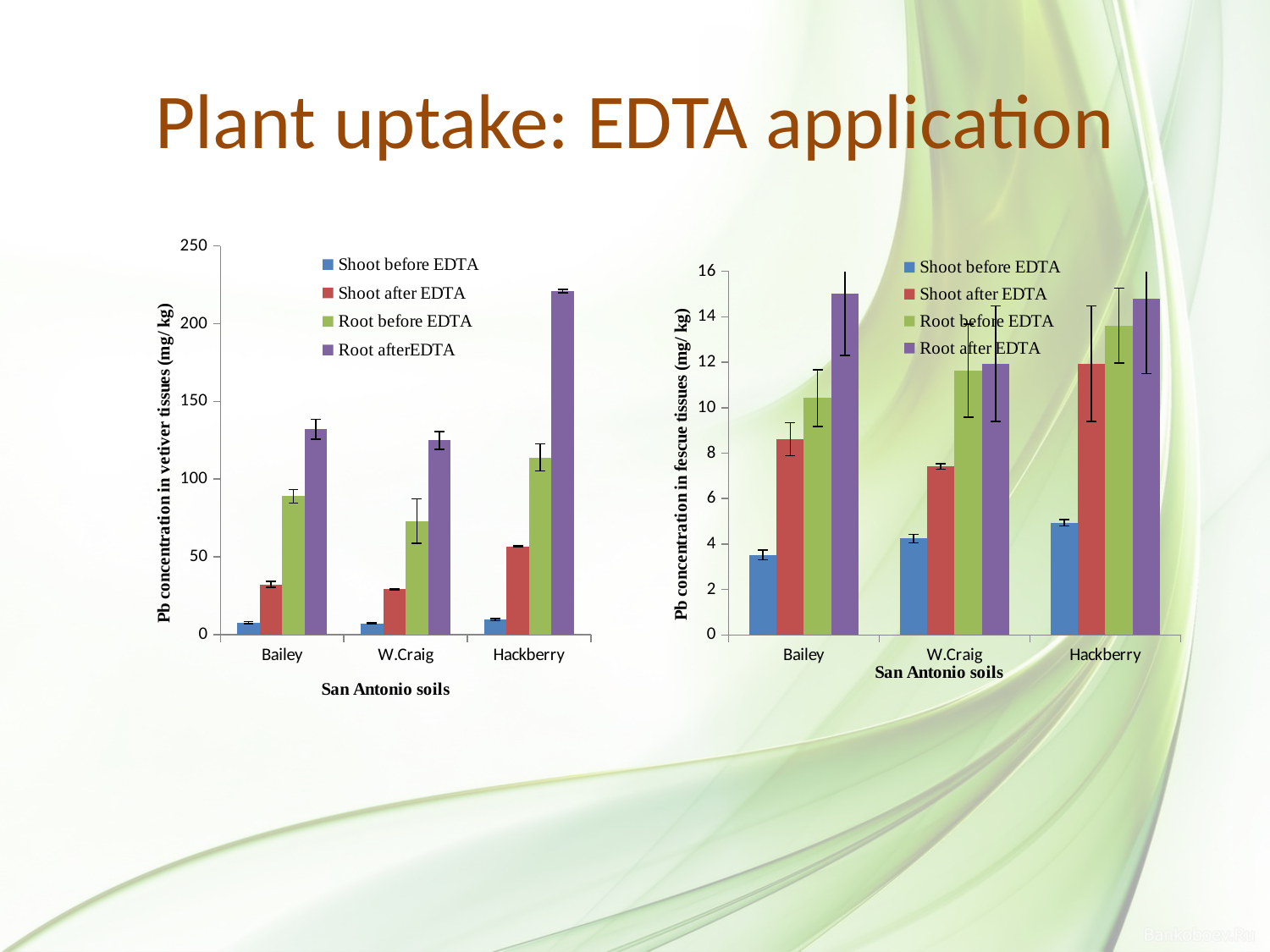
In the left chart (vetiver tissues), how many series does the legend list? 4 What is the y-axis label of the right chart? Pb concentration in fescue tissues (mg/ kg) In the left chart (vetiver tissues), which soil has the highest Root after EDTA value? Hackberry In the right chart (fescue tissues), is the Root after EDTA value for Bailey greater or less than 14? greater In the left chart (vetiver tissues), which is larger: the Shoot after EDTA value for Hackberry or for Bailey? Hackberry In the right chart (fescue tissues), is the Shoot after EDTA value for W.Craig greater or less than 8? less In the left chart (vetiver tissues), how many soil categories are shown on the x axis? 3 In the left chart (vetiver tissues), is the Root before EDTA value for Bailey greater or less than 100? less In the right chart (fescue tissues), which soil has the lowest Shoot before EDTA value? Bailey What kind of chart is the left chart (Pb concentration in vetiver tissues)? bar chart In the right chart (fescue tissues), which soil has the highest Shoot after EDTA value? Hackberry